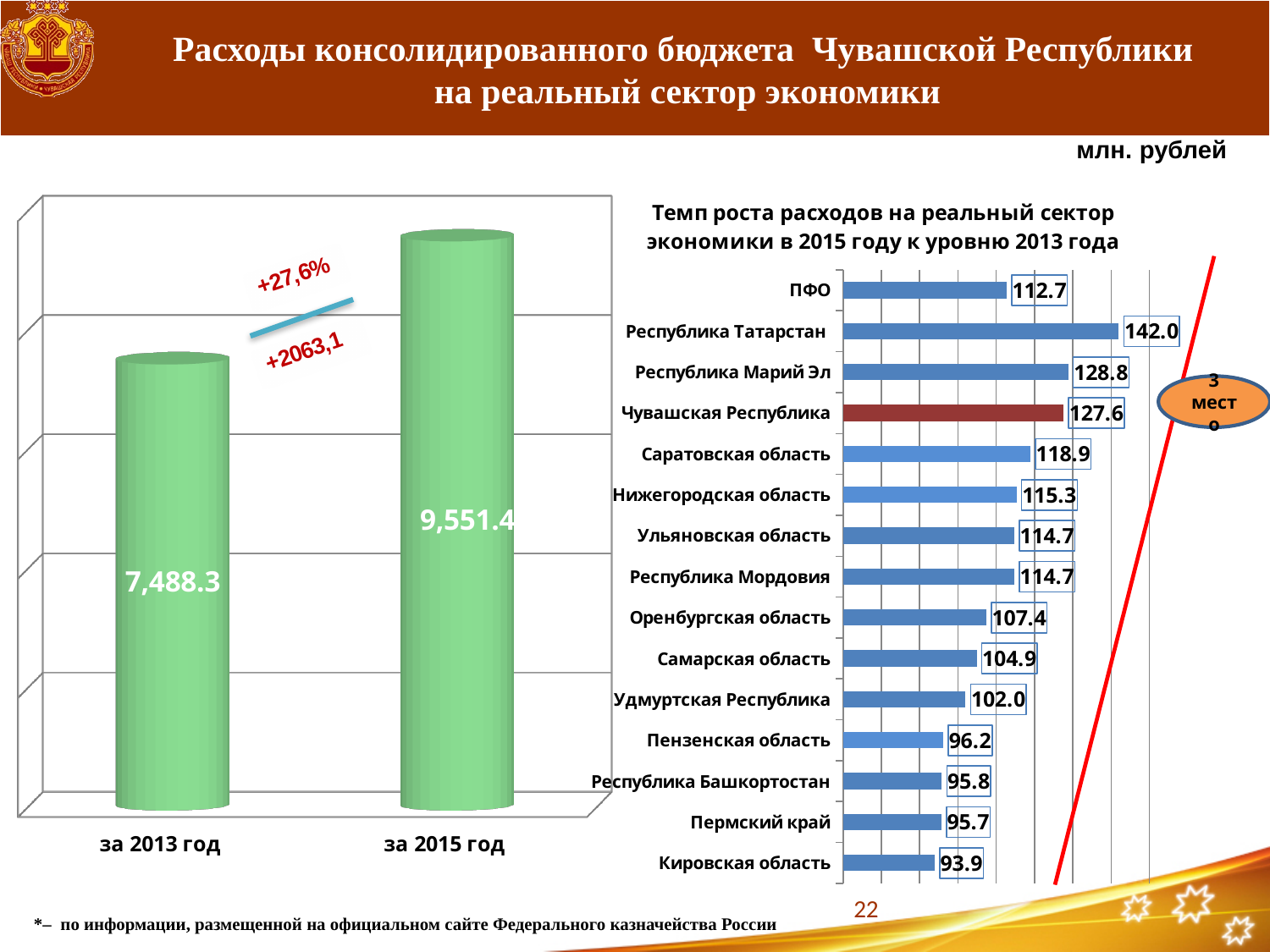
In the chart titled 'Темп роста расходов на реальный сектор экономики в 2015 году к уровню 2013 года', which region has the highest value? Республика Татарстан In the chart titled 'Темп роста расходов на реальный сектор экономики в 2015 году к уровню 2013 года', what is the value for Республика Татарстан? 142.0 In the chart titled 'Темп роста расходов на реальный сектор экономики в 2015 году к уровню 2013 года', which region has the lowest value? Кировская область In the left chart, do the values rise or fall from 2013 to 2015? rise In the chart titled 'Темп роста расходов на реальный сектор экономики в 2015 году к уровню 2013 года', what is the value for Чувашская Республика? 127.6 In the left chart, what is the value for за 2015 год? 9,551.4 In the left chart, which year has the larger value, за 2013 год or за 2015 год? за 2015 год In the left chart, how many bars are plotted? 2 In the left chart, what is the value for за 2013 год? 7,488.3 In the chart titled 'Темп роста расходов на реальный сектор экономики в 2015 году к уровню 2013 года', how many categories are plotted? 15 In the chart titled 'Темп роста расходов на реальный сектор экономики в 2015 году к уровню 2013 года', what is the difference between Республика Татарстан and Чувашская Республика? 14.4 What kind of chart is the one titled 'Темп роста расходов на реальный сектор экономики в 2015 году к уровню 2013 года'? bar chart